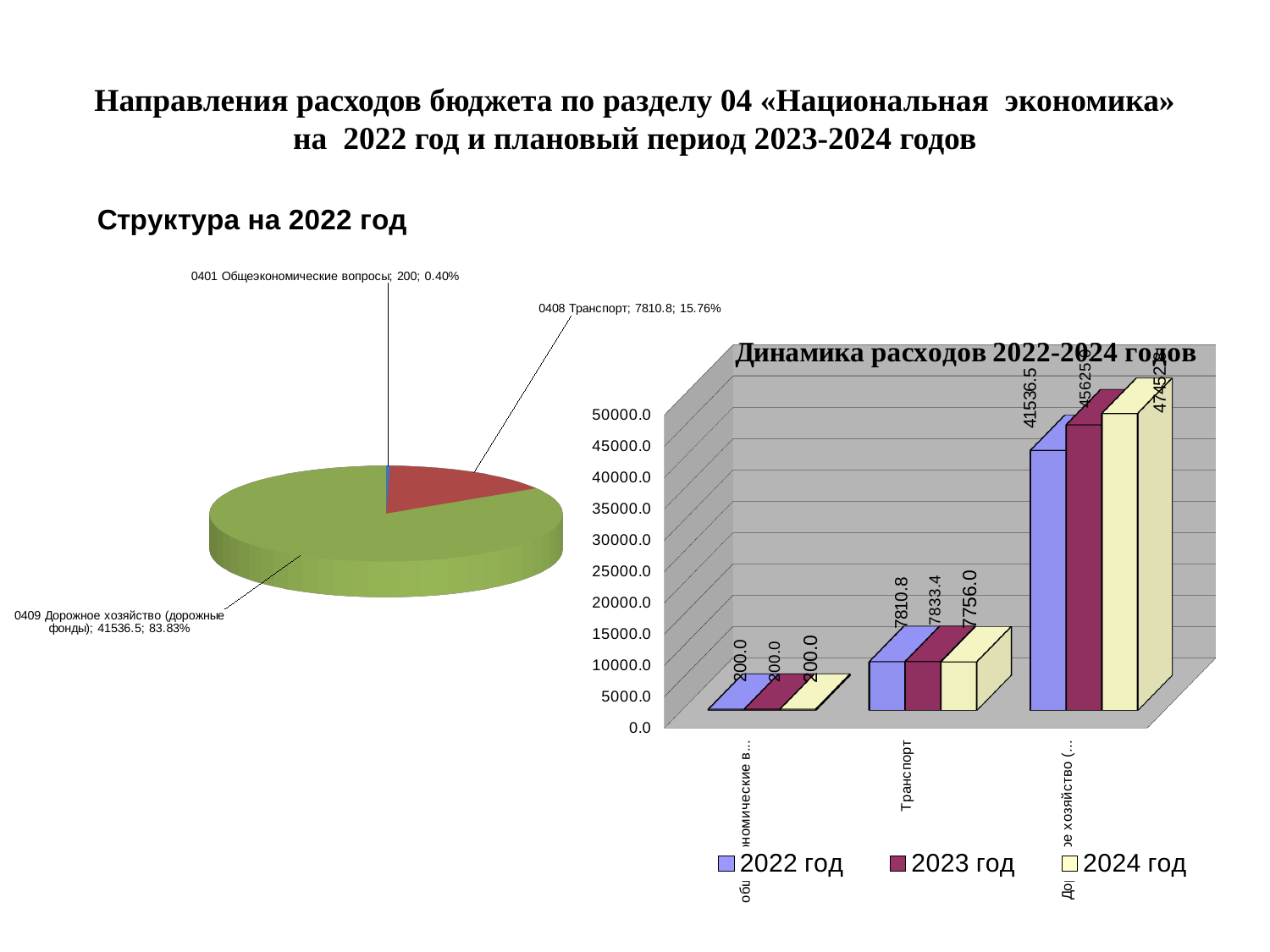
In the chart 'Динамика расходов 2022-2024 годов', what is the value for Транспорт in 2023 год? 7833.4 In the chart 'Динамика расходов 2022-2024 годов', which is larger for Транспорт: 2022 год or 2023 год? 2023 год In the pie chart 'Структура на 2022 год', which category has the largest slice? 0409 Дорожное хозяйство (дорожные фонды) In the chart 'Динамика расходов 2022-2024 годов', how many series does the legend list? 3 In the pie chart 'Структура на 2022 год', which category has the smallest slice? 0401 Общеэкономические вопросы In the pie chart 'Структура на 2022 год', what share does 0401 Общеэкономические вопросы have? 0.40% What kind of chart is 'Динамика расходов 2022-2024 годов'? bar chart In the chart 'Динамика расходов 2022-2024 годов', what is the value for Транспорт in 2024 год? 7756.0 In the pie chart 'Структура на 2022 год', how many slices are there? 3 In the pie chart 'Структура на 2022 год', what is the value for 0409 Дорожное хозяйство (дорожные фонды)? 41536.5 In the pie chart 'Структура на 2022 год', what share does 0408 Транспорт have? 15.76% In the chart 'Динамика расходов 2022-2024 годов', what is the difference between the Транспорт values for 2023 год and 2024 год? 77.4